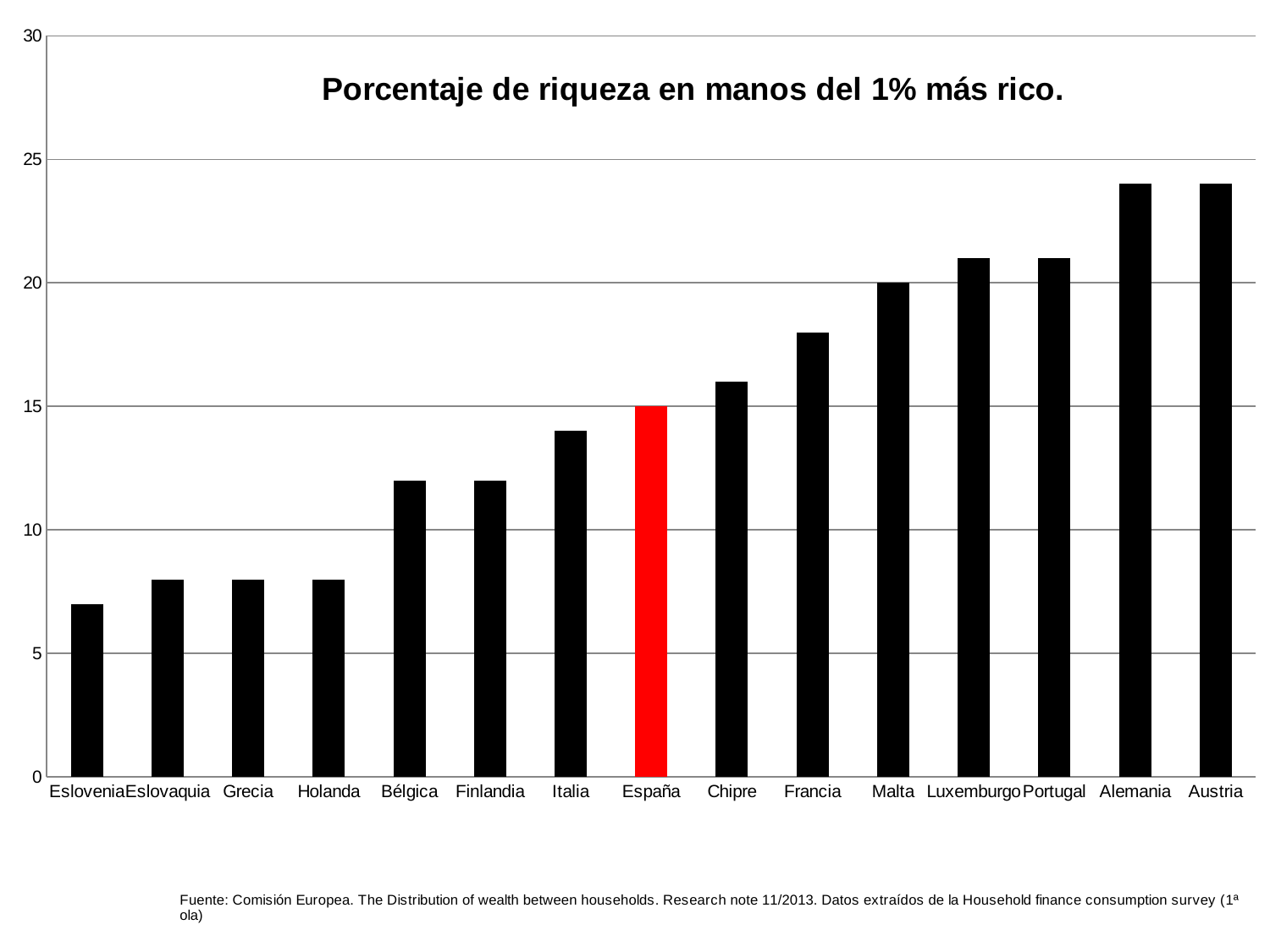
Is the value for Francia greater or less than 15? greater Which country's bar is coloured red in the chart? España Is the value for Bélgica greater or less than 15? less What is the value for España? 15 Which country has the lowest value in the chart? Eslovenia What kind of chart is shown on the slide? Bar chart How many countries are shown on the x axis of the chart? 15 Which has a larger value, Francia or Italia? Francia Is the value for Holanda greater or less than 10? less What is the value for Malta? 20 Do the values generally rise or fall from left to right along the x axis? Rise